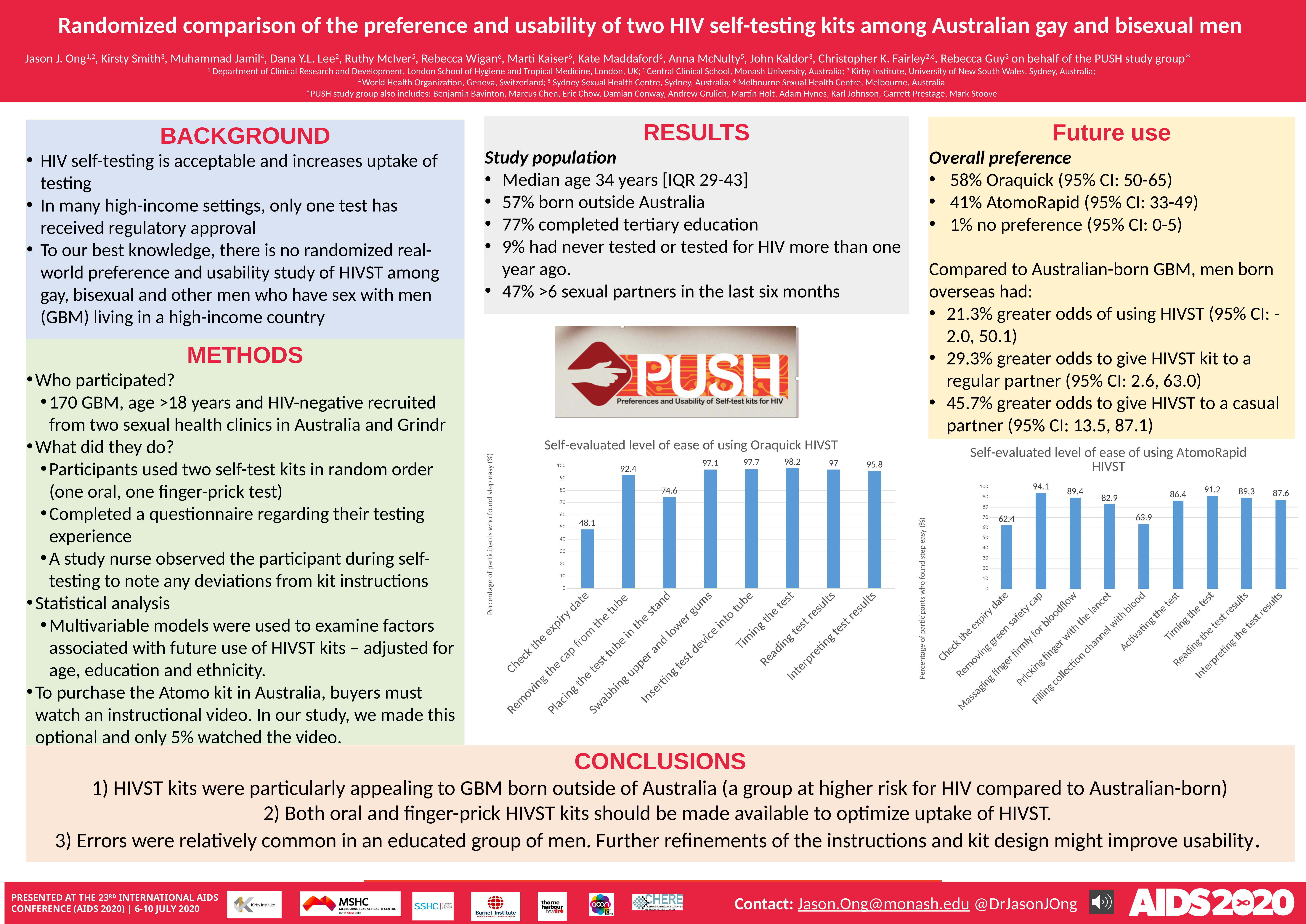
In the 'Self-evaluated level of ease of using Oraquick HIVST' chart, what is the difference between 'Removing the cap from the tube' and 'Placing the test tube in the stand'? 17.8 In the 'Self-evaluated level of ease of using Oraquick HIVST' chart, what is the value for 'Check the expiry date'? 48.1 In the 'Self-evaluated level of ease of using AtomoRapid HIVST' chart, which step has the highest value? Removing green safety cap In the 'Self-evaluated level of ease of using Oraquick HIVST' chart, which step has the highest value? Timing the test How many steps are shown in the 'Self-evaluated level of ease of using AtomoRapid HIVST' chart? 9 In the 'Self-evaluated level of ease of using AtomoRapid HIVST' chart, which is larger: 'Timing the test' or 'Activating the test'? Timing the test In the 'Self-evaluated level of ease of using AtomoRapid HIVST' chart, what is the value for 'Filling collection channel with blood'? 63.9 In the 'Self-evaluated level of ease of using AtomoRapid HIVST' chart, what is the difference between 'Pricking finger with the lancet' and 'Check the expiry date'? 20.5 In the 'Self-evaluated level of ease of using AtomoRapid HIVST' chart, which step has the lowest value? Check the expiry date What type of chart is the 'Self-evaluated level of ease of using Oraquick HIVST' chart? Bar chart How many steps are shown in the 'Self-evaluated level of ease of using Oraquick HIVST' chart? 8 In the 'Self-evaluated level of ease of using Oraquick HIVST' chart, which step has the lowest value? Check the expiry date